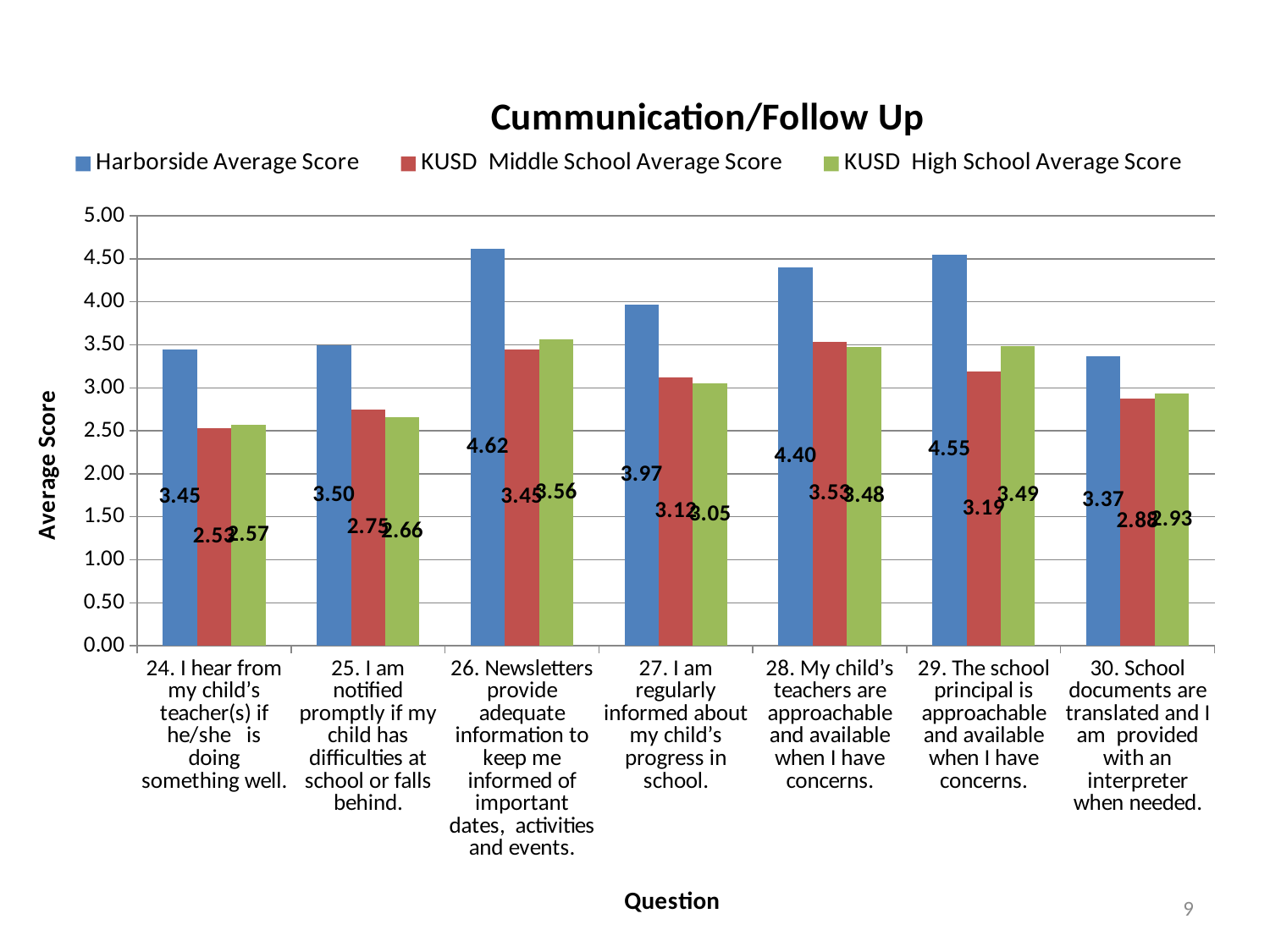
What is the Harborside Average Score for question 26 (Newsletters provide adequate information)? 4.62 Is the Harborside Average Score for question 27 greater or less than 3.50? greater Which question has the lowest Harborside Average Score? 30. School documents are translated and I am provided with an interpreter when needed. What kind of chart is shown on the slide? bar chart What is the KUSD Middle School Average Score for question 25 (I am notified promptly if my child has difficulties)? 2.75 For question 28, what is the difference between the Harborside Average Score and the KUSD Middle School Average Score? 0.87 What is the title of the chart? Cummunication/Follow Up How many questions (categories) are plotted on the x axis? 7 How many series does the legend list? 3 Which question has the highest Harborside Average Score? 26. Newsletters provide adequate information to keep me informed of important dates, activities and events. For question 29, which is larger: the KUSD Middle School Average Score or the KUSD High School Average Score? KUSD High School Average Score What is the Harborside Average Score for question 29 (The school principal is approachable and available)? 4.55